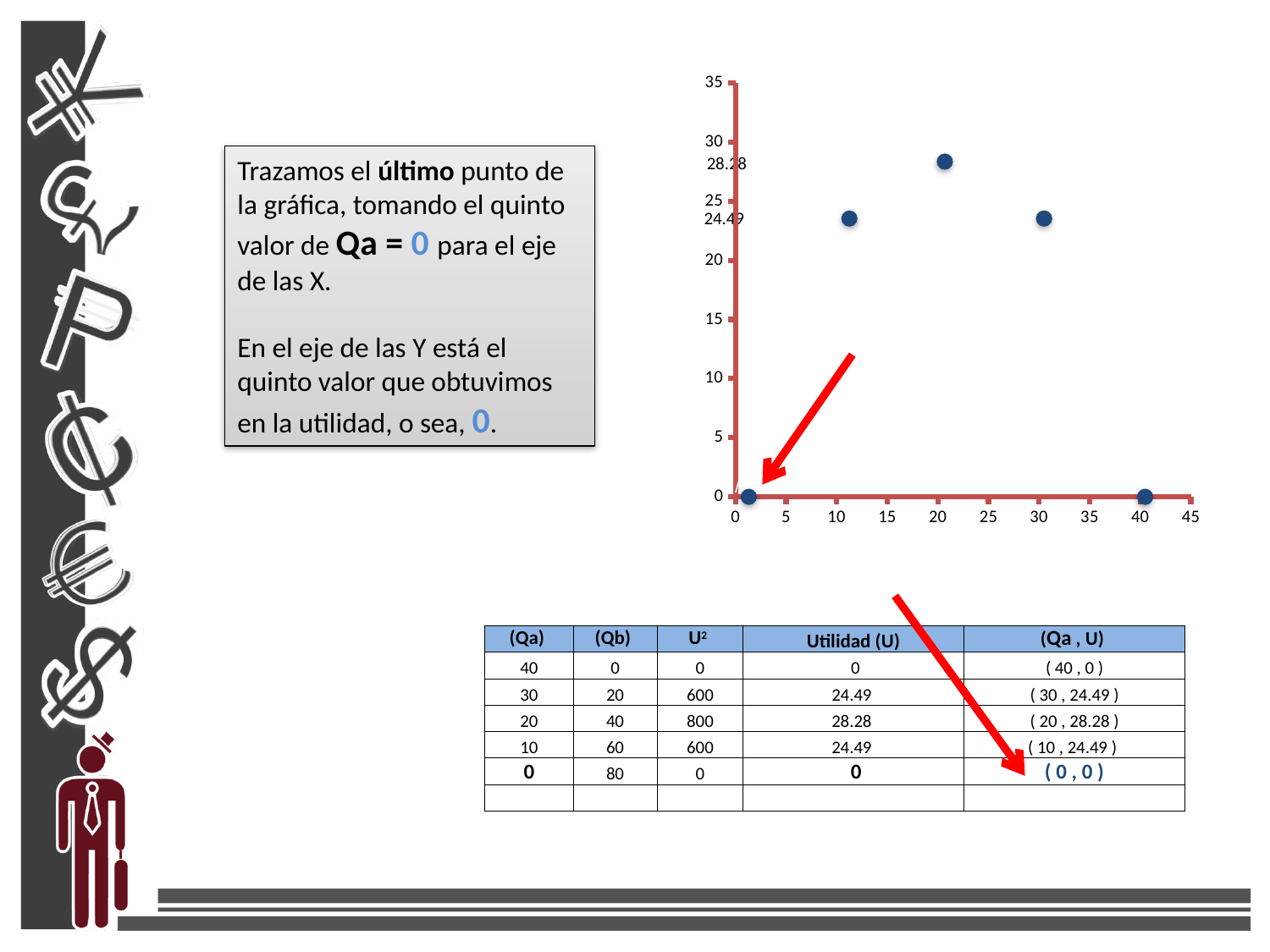
Is the utility plotted at Qa = 20 greater or less than 25? greater What are the coordinates of the last point added to the chart, indicated by the red arrow? (0, 0) Which is larger, the utility at Qa = 20 or the utility at Qa = 10? Qa = 20 What is the utility (U) value plotted at Qa = 20? 28.28 What is the utility (U) value plotted at Qa = 30? 24.49 What is the utility (U) value plotted at Qa = 40? 0 What is the highest value shown on the y axis of the scatter chart? 35 How many data points are plotted on the scatter chart? 5 What kind of chart is shown on the slide? scatter chart What is the difference between the utility at Qa = 20 and the utility at Qa = 30? 3.79 At which Qa value does the plotted utility reach its highest point? 20 Is the utility plotted at Qa = 10 greater or less than 25? less